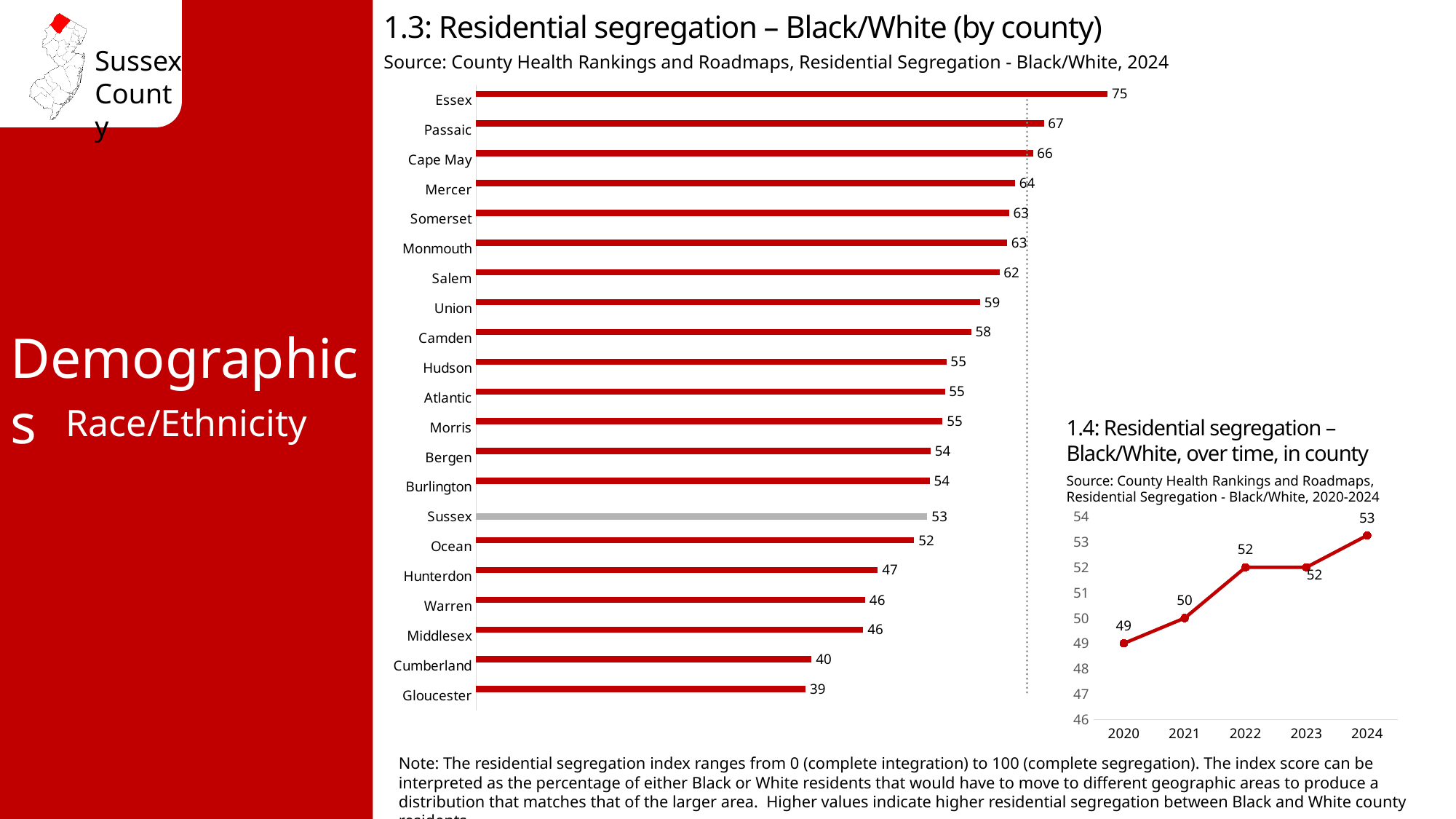
In chart 1.3 (by county), which county has the lowest residential segregation index? Gloucester In chart 1.3 (by county), what is the difference between the values for Essex and Sussex? 22 In chart 1.3 (by county), which has a higher value, Passaic or Cape May? Passaic In chart 1.4 (Residential segregation over time, in county), what is the value for 2020? 49 In chart 1.3 (by county), which county has the highest residential segregation index? Essex In chart 1.3 (by county), what is the value for Cumberland? 40 What kind of chart is chart 1.3 (Residential segregation – Black/White by county)? Bar chart In chart 1.4 (over time, in county), how many years are plotted? 5 In chart 1.4 (over time, in county), do the values rise or fall from 2020 to 2024? Rise In chart 1.3 (Residential segregation – Black/White by county), what is the value for Sussex? 53 In chart 1.4 (over time, in county), what is the difference between the 2024 and 2020 values? 4 In chart 1.3 (by county), how many counties are shown? 21